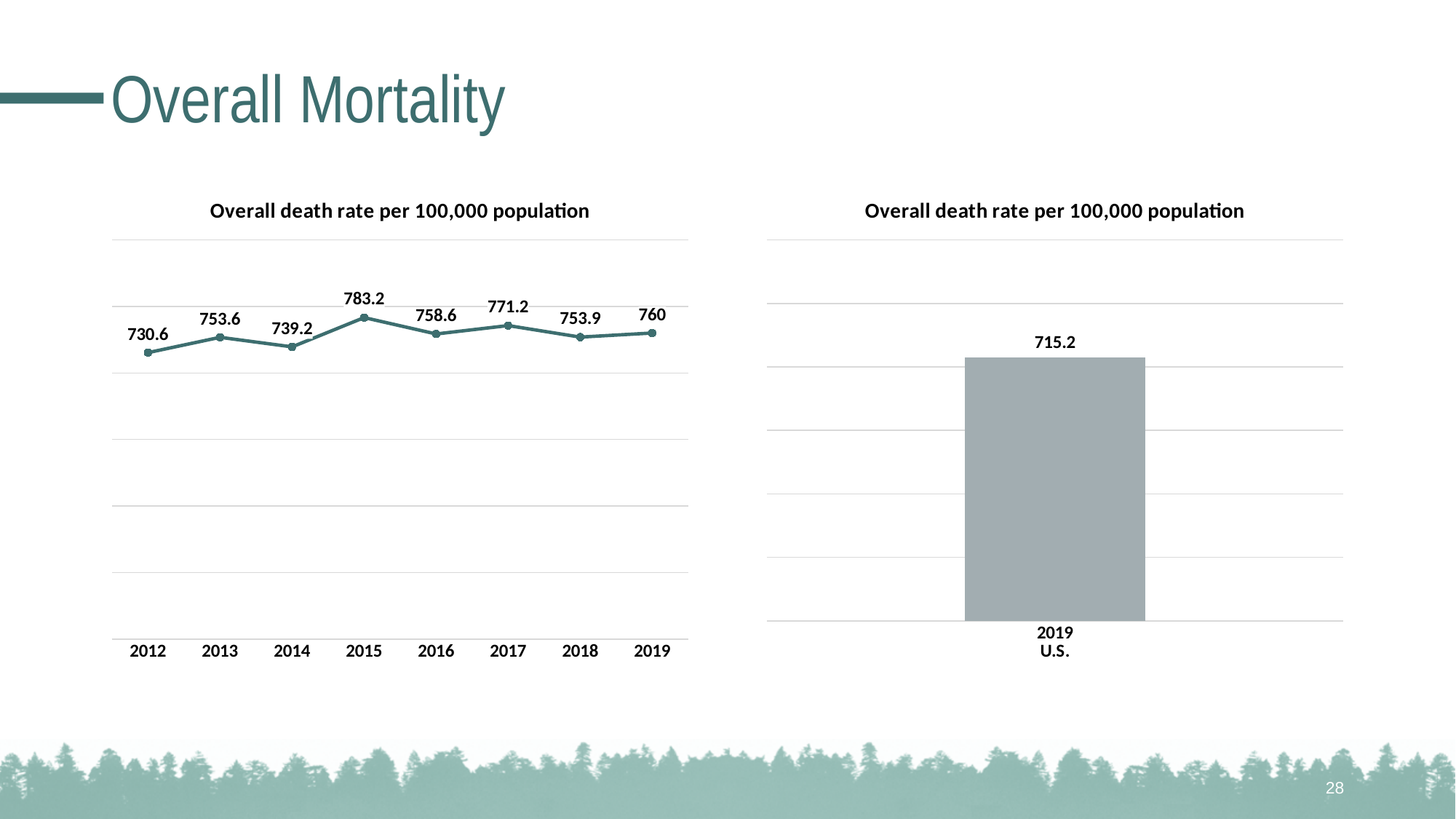
In the left chart, what is the overall death rate per 100,000 population for 2012? 730.6 In the left chart, what is the difference between the 2015 value and the 2012 value? 52.6 In the right chart, what is the overall death rate per 100,000 population for 2019 U.S.? 715.2 What kind of chart is the left chart? line chart In the left chart, what is the value for 2019? 760 What kind of chart is the right chart? bar chart In the left chart, which year has the larger value, 2017 or 2018? 2017 In the left chart, which year has the highest overall death rate? 2015 Is the 2019 value in the left chart larger or smaller than the 2019 U.S. value in the right chart? larger How many years are plotted in the left chart? 8 In the left chart, what is the overall death rate per 100,000 population for 2015? 783.2 In the left chart, which year has the lowest overall death rate? 2012